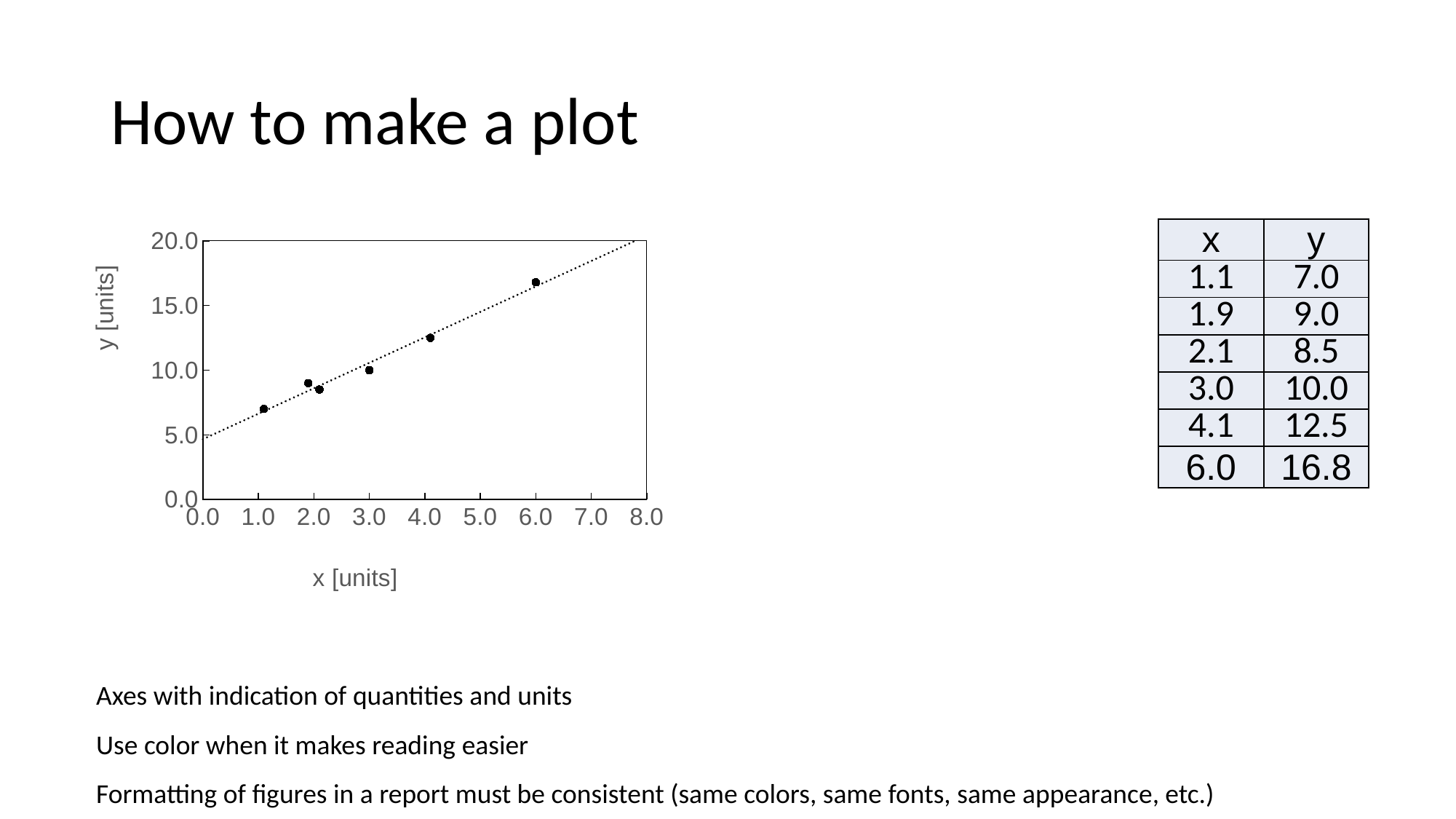
How many data points are plotted in the chart? 6 What kind of chart is shown on the slide? scatter plot What is the label of the vertical axis? y [units] Is the y value at x = 6.0 greater or less than 15.0? greater Do the y values rise or fall as x increases? rise What is the y value at x = 6.0? 16.8 Which x value has the highest y value? 6.0 What is the difference between the y values at x = 6.0 and x = 4.1? 4.3 Which is larger, the y value at x = 1.9 or at x = 2.1? x = 1.9 Which x value has the lowest y value? 1.1 What is the y value at x = 3.0? 10.0 What is the y value at x = 1.1? 7.0